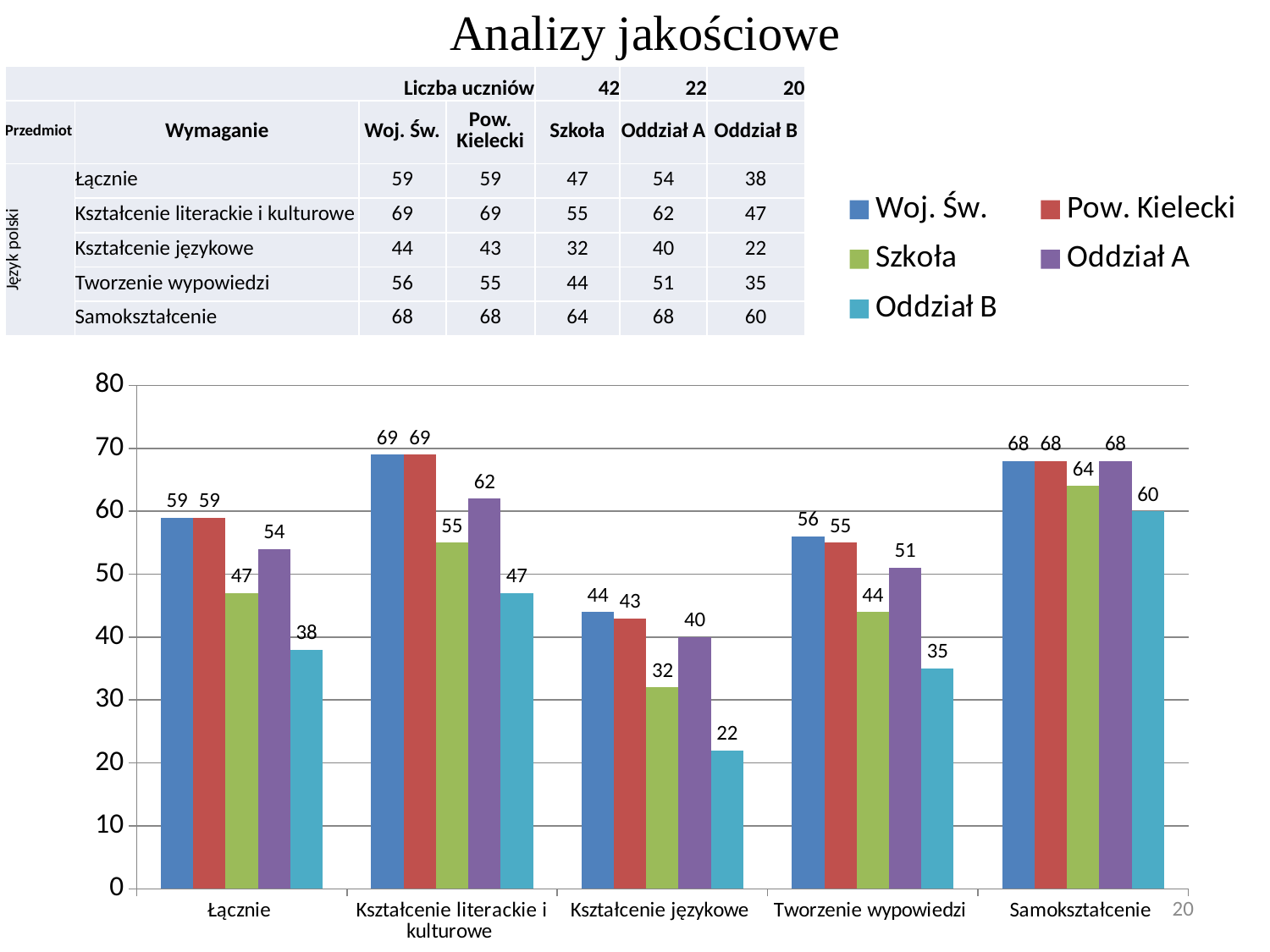
What kind of chart is shown on the slide? bar chart Which is larger in the Kształcenie literackie i kulturowe category: Szkoła or Oddział A? Oddział A What is the difference between Woj. Św. and Oddział B in the Łącznie category? 21 What is the value for Szkoła in the Samokształcenie category? 64 What is the value for Oddział B in the Kształcenie językowe category? 22 Is the value for Oddział B in the Samokształcenie category greater or less than 50? greater How many categories are shown on the x axis? 5 Which category has the lowest value for Oddział B? Kształcenie językowe How many series does the legend list? 5 Which series is shown in light blue in the legend? Oddział B Which category has the highest value for Szkoła? Samokształcenie What is the value for Oddział A in the Tworzenie wypowiedzi category? 51